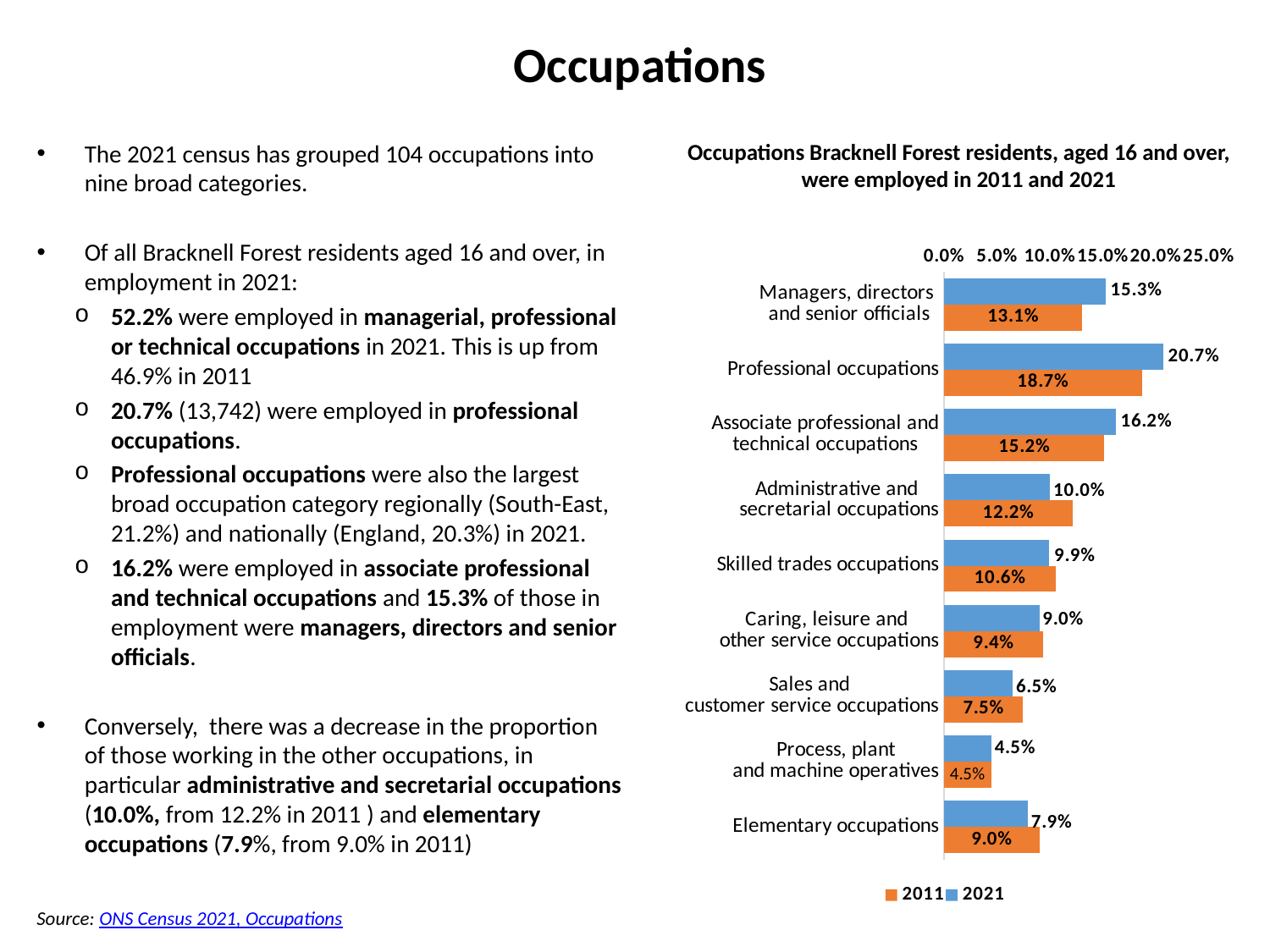
What is the difference between the 2021 and 2011 values for Managers, directors and senior officials? 2.2% For Skilled trades occupations, which year has the larger value, 2011 or 2021? 2011 How many occupation categories are shown in the chart? 9 Which colour represents the 2021 series in the chart? blue What is the 2011 value for Administrative and secretarial occupations? 12.2% How many series does the chart legend list? 2 What is the 2021 value for Professional occupations? 20.7% Which occupation category has the lowest 2011 value? Process, plant and machine operatives Which occupation category has the highest 2021 value? Professional occupations Is the 2021 value for Associate professional and technical occupations greater or less than 15.0%? greater What type of chart is shown on the slide? bar chart What is the 2021 value for Elementary occupations? 7.9%